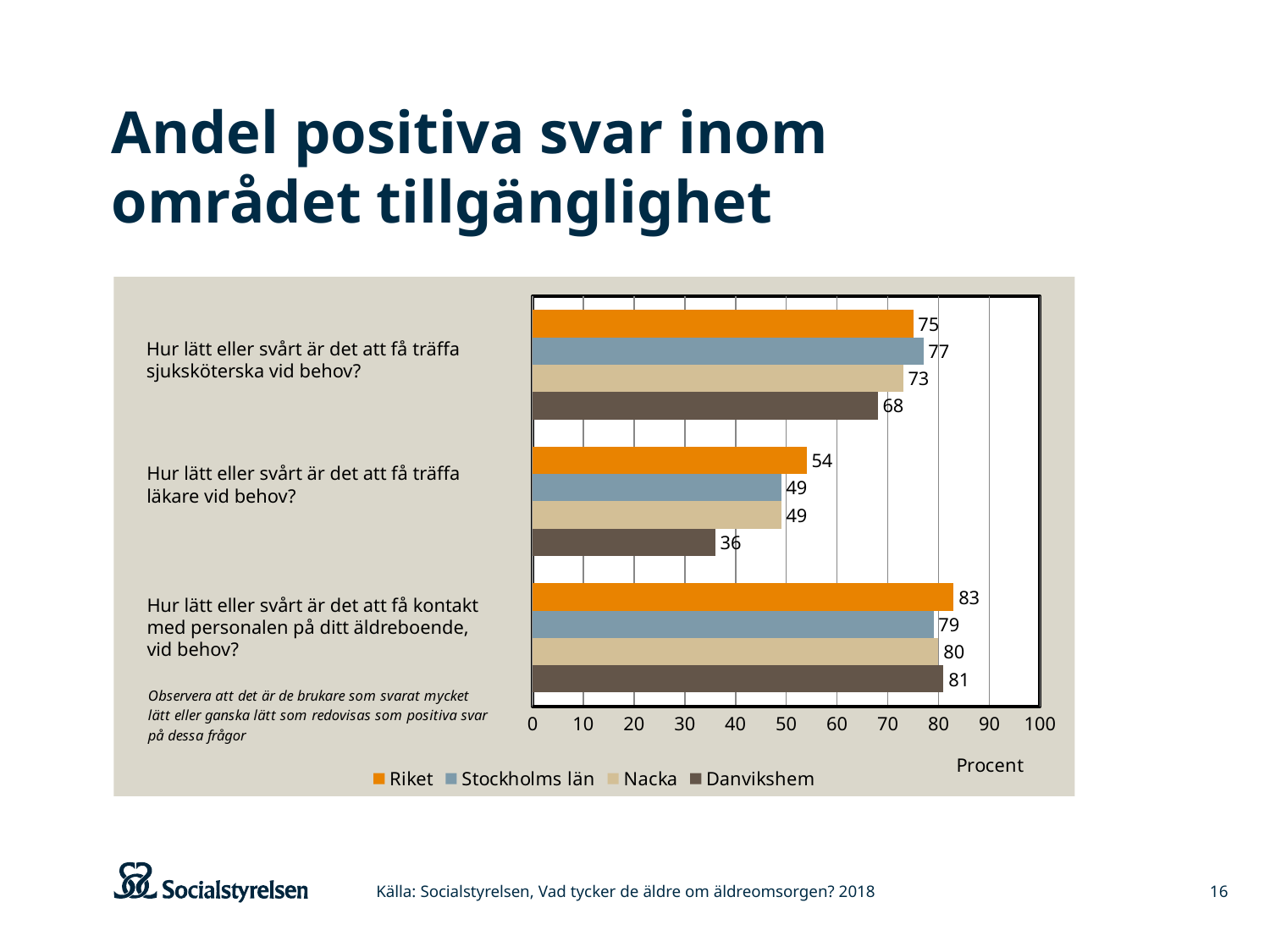
How many series does the legend list? 4 What kind of chart is shown on the slide? Bar chart What is the value for Danvikshem on the question "Hur lätt eller svårt är det att få träffa läkare vid behov?"? 36 What is the difference between Riket and Danvikshem on the question "Hur lätt eller svårt är det att få träffa läkare vid behov?"? 18 Which series has the highest value on the question "Hur lätt eller svårt är det att få träffa sjuksköterska vid behov?"? Stockholms län Which is larger on the question "Hur lätt eller svårt är det att få kontakt med personalen på ditt äldreboende, vid behov?": Riket or Stockholms län? Riket What is the value for Nacka on the question "Hur lätt eller svårt är det att få träffa sjuksköterska vid behov?"? 73 Which series has the lowest value on the question "Hur lätt eller svårt är det att få träffa läkare vid behov?"? Danvikshem What is the value for Riket on the question "Hur lätt eller svårt är det att få kontakt med personalen på ditt äldreboende, vid behov?"? 83 Is the value for Danvikshem on the question "Hur lätt eller svårt är det att få träffa sjuksköterska vid behov?" greater or less than 60? greater What unit label is shown on the x axis of the chart? Procent How many question categories are plotted on the chart? 3